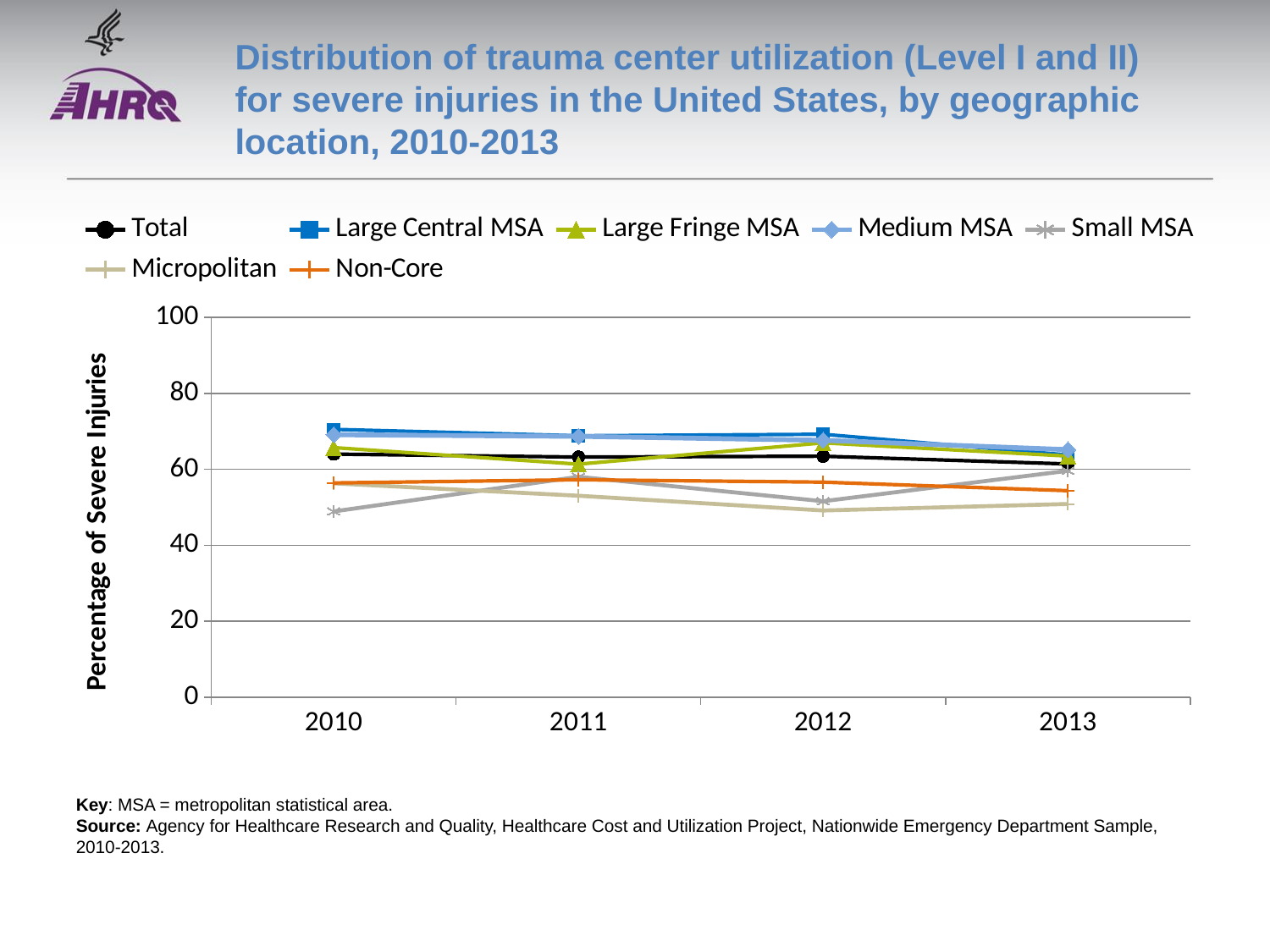
Is the value for Medium MSA in 2013 greater or less than 80? less How many years are shown along the x axis? 4 What is the label on the y axis? Percentage of Severe Injuries Which series has the lowest value in 2010? Small MSA Is the value for Small MSA in 2010 greater or less than 60? less How many series does the legend list? 7 What kind of chart is shown on the slide? Line chart Is the Small MSA value in 2013 higher or lower than in 2010? Higher Is the value for Large Central MSA in 2010 greater or less than 60? greater Does the Micropolitan series rise or fall from 2010 to 2012? Fall In 2012, which is larger: Large Central MSA or Micropolitan? Large Central MSA